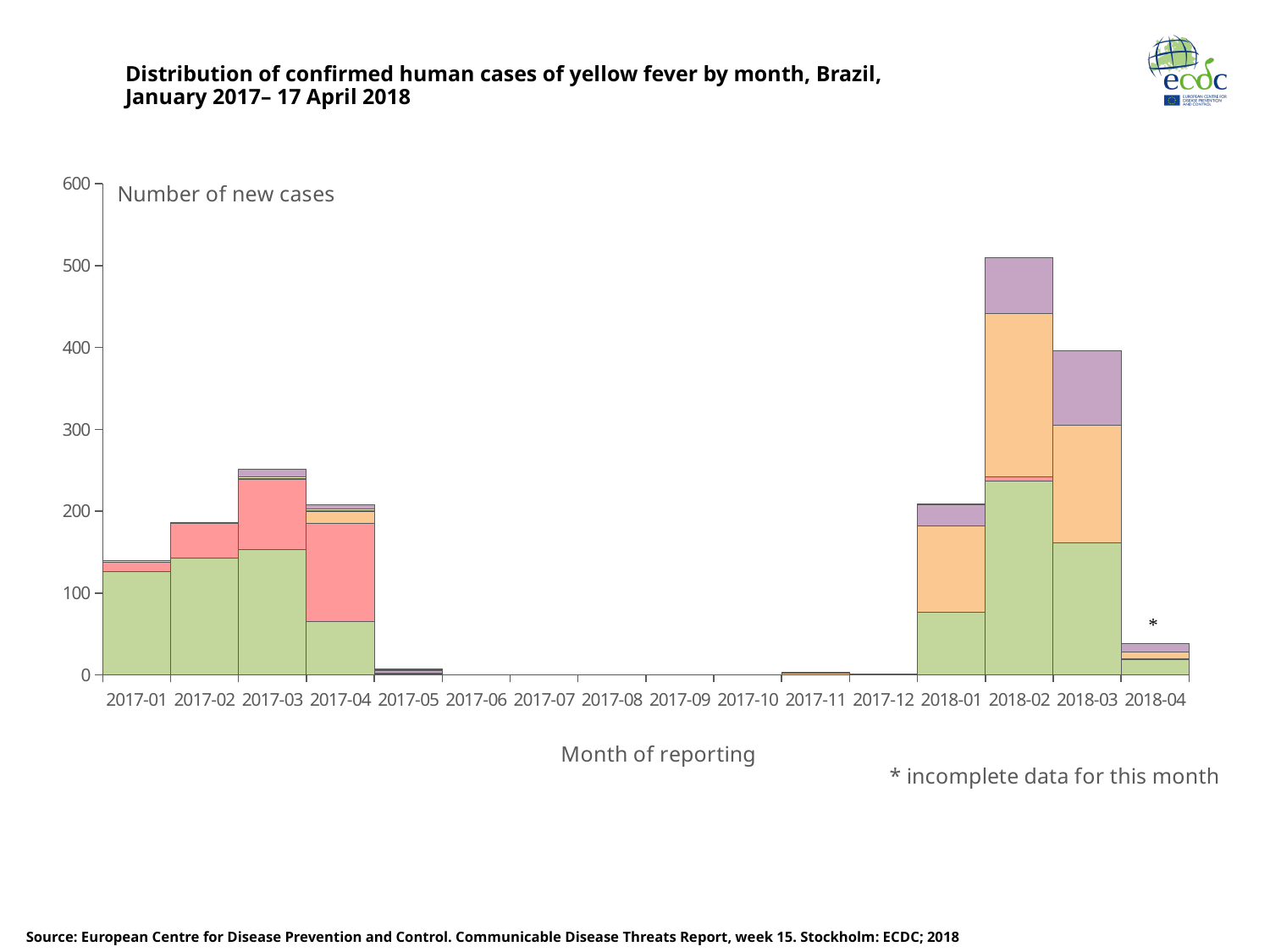
Is the total number of new cases for 2018-04 greater or less than 100? less Is the total number of new cases for 2018-02 greater or less than 400? greater What kind of chart is shown on the slide? Stacked bar chart Is the total number of new cases for 2017-03 greater or less than 200? greater How many months are shown along the x axis? 16 Do the total number of new cases rise or fall from 2018-02 to 2018-04? fall Which month has a higher total number of new cases, 2018-02 or 2018-03? 2018-02 Which month has the highest total number of new cases? 2018-02 What does the asterisk above the 2018-04 bar indicate? Incomplete data for this month